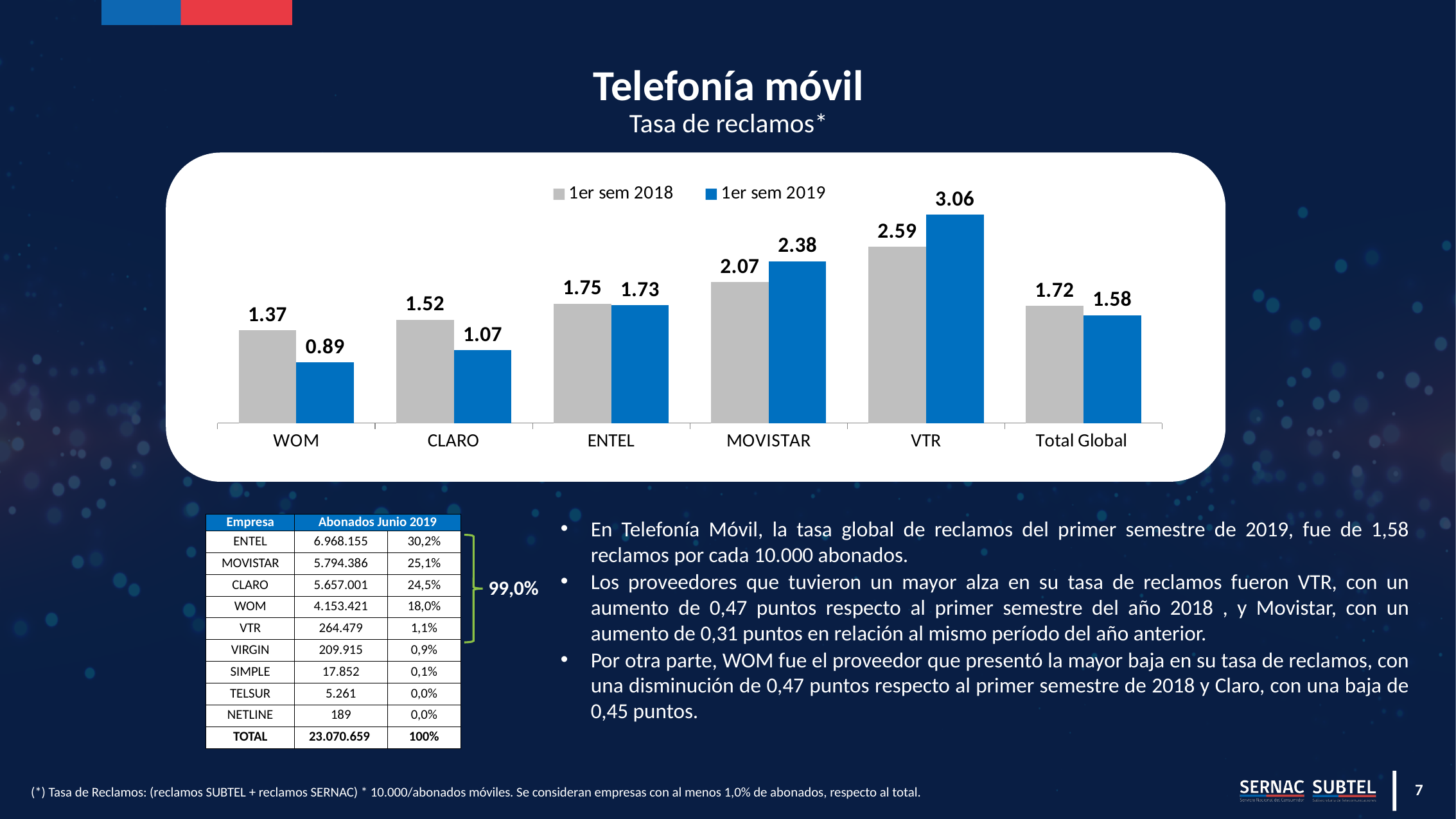
What is the value for WOM in the 1er sem 2018 series? 1.37 What is the difference between the 1er sem 2019 and 1er sem 2018 values for MOVISTAR? 0.31 What is the value for VTR in the 1er sem 2019 series? 3.06 What kind of chart is shown on the slide? Bar chart How many categories are shown on the x axis of the chart? 6 Which category has the highest value in the 1er sem 2019 series? VTR Which category has the lowest value in the 1er sem 2019 series? WOM What is the difference between the 1er sem 2018 and 1er sem 2019 values for WOM? 0.48 Which colour represents the 1er sem 2019 series in the chart? Blue What is the value for Total Global in the 1er sem 2019 series? 1.58 How many series does the legend list? 2 Which is larger for CLARO: the 1er sem 2018 value or the 1er sem 2019 value? 1er sem 2018